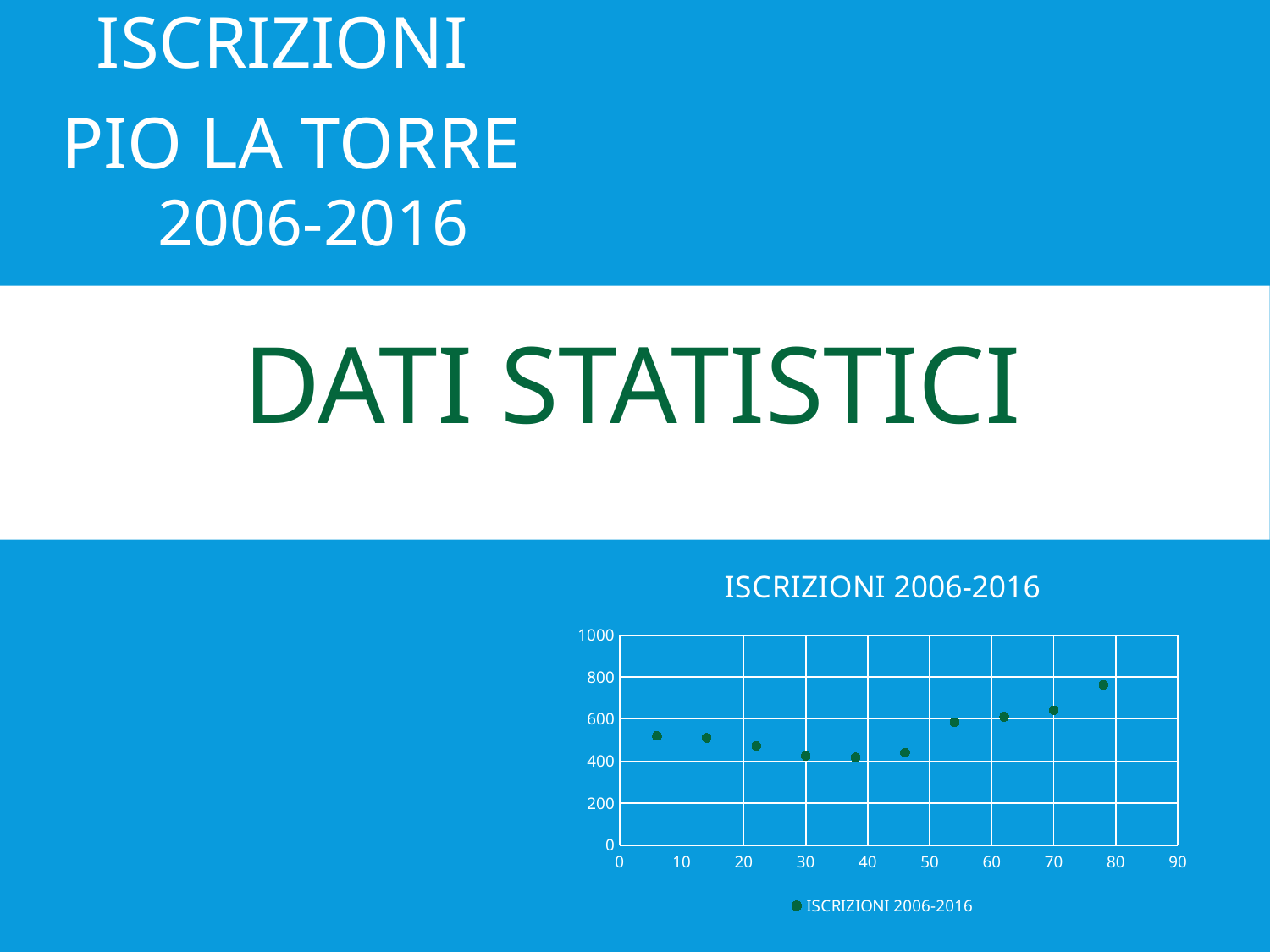
Which has the larger value, the leftmost point or the rightmost point? The rightmost point Is the value of the rightmost point in the chart greater or less than 600? greater What is the maximum value shown on the chart's vertical axis? 1000 What is the name of the series shown in the chart legend? ISCRIZIONI 2006-2016 Which point in the chart has the highest value? The rightmost point What kind of chart is shown on the slide? Scatter chart How many data points are plotted in the chart? 10 Comparing the first point to the last point along the x axis, do the values rise or fall overall? rise How many series does the chart legend list? 1 Is the value of the leftmost point in the chart greater or less than 600? less Is the value of the leftmost point in the chart greater or less than 400? greater What is the title of the chart on the slide? ISCRIZIONI 2006-2016